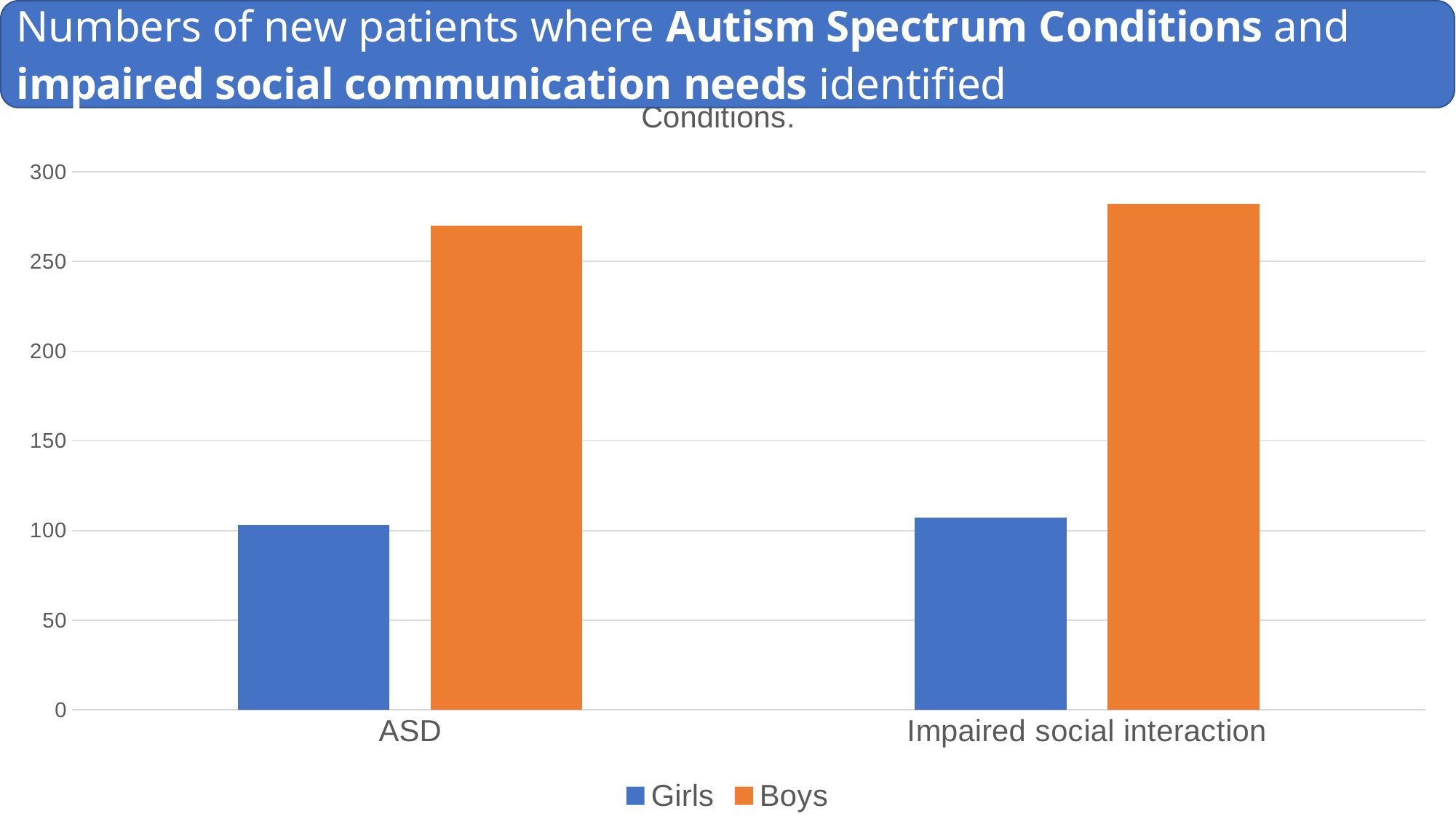
Which series has the higher value for ASD, Girls or Boys? Boys What colour are the bars for the Boys series? orange How many categories are shown on the x axis? 2 Which series has the higher value for Impaired social interaction, Girls or Boys? Boys Which bar is the tallest in the chart? Boys, Impaired social interaction What are the two series named in the legend? Girls and Boys Is the value for Girls in the ASD category greater or less than 150? less How many series does the legend list? 2 What kind of chart is shown on the slide? bar chart Is the value for Girls in the Impaired social interaction category greater or less than 150? less Is the value for Boys in the Impaired social interaction category greater or less than 300? less